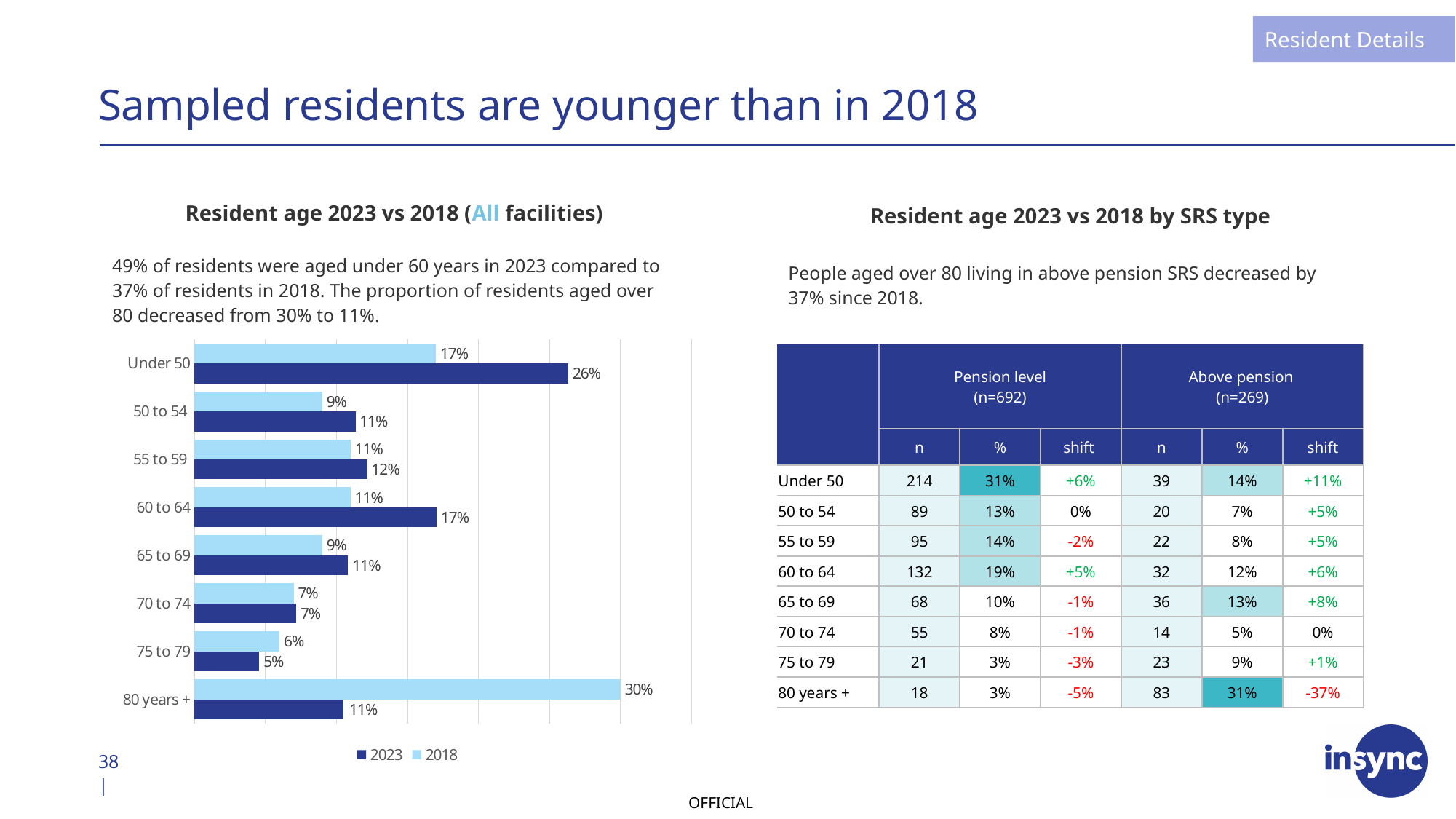
In the bar chart, which age group has the highest 2018 value? 80 years + In the bar chart, which is larger for 60 to 64: the 2023 value or the 2018 value? 2023 In the bar chart, which age group has the lowest 2023 value? 75 to 79 How many age groups are shown in the bar chart? 8 What type of chart is shown on the slide? bar chart How many series does the bar chart's legend list? 2 In the bar chart, which age group has the highest 2023 value? Under 50 In the bar chart, what is the 2023 value for Under 50? 26% In the bar chart, what is the difference between the 2018 and 2023 values for 80 years +? 19% In the bar chart, what is the 2018 value for 80 years +? 30% In the bar chart, what is the 2023 value for 60 to 64? 17% In the bar chart, what is the 2018 value for 75 to 79? 6%